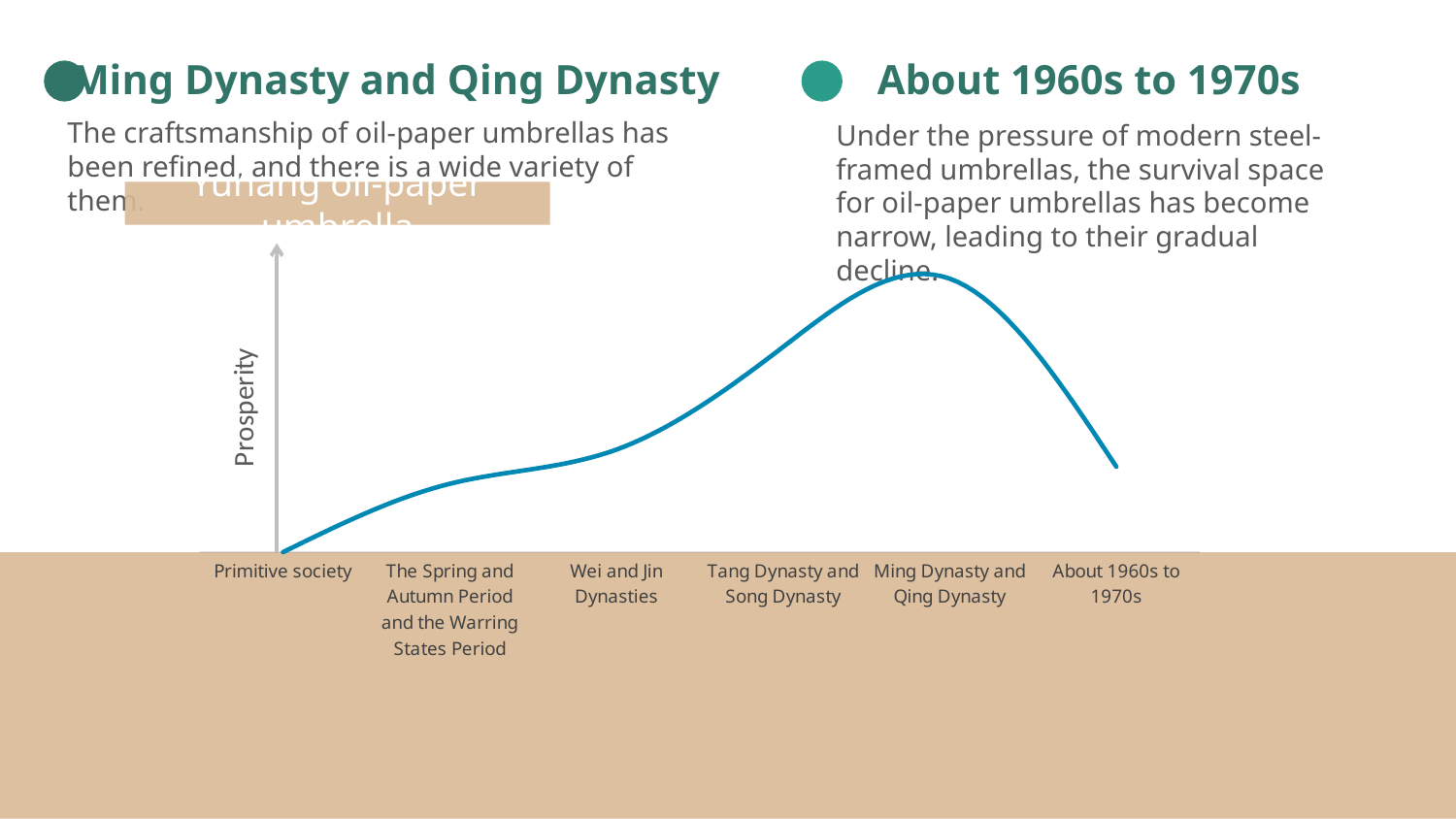
Which has higher prosperity on the chart, Primitive society or About 1960s to 1970s? About 1960s to 1970s Does the prosperity line rise or fall from Primitive society to Ming Dynasty and Qing Dynasty? rise What kind of chart is shown on the slide? line chart Which has higher prosperity on the chart, The Spring and Autumn Period and the Warring States Period or Ming Dynasty and Qing Dynasty? Ming Dynasty and Qing Dynasty Which has higher prosperity on the chart, Wei and Jin Dynasties or Tang Dynasty and Song Dynasty? Tang Dynasty and Song Dynasty How many periods are labelled along the x axis of the chart? 6 What is the first period labelled on the x axis of the chart? Primitive society Which period on the x axis has the lowest prosperity on the chart? Primitive society Does the prosperity line rise or fall from Ming Dynasty and Qing Dynasty to About 1960s to 1970s? fall Which period on the x axis has the highest prosperity on the chart? Ming Dynasty and Qing Dynasty What is the label on the vertical axis of the chart? Prosperity